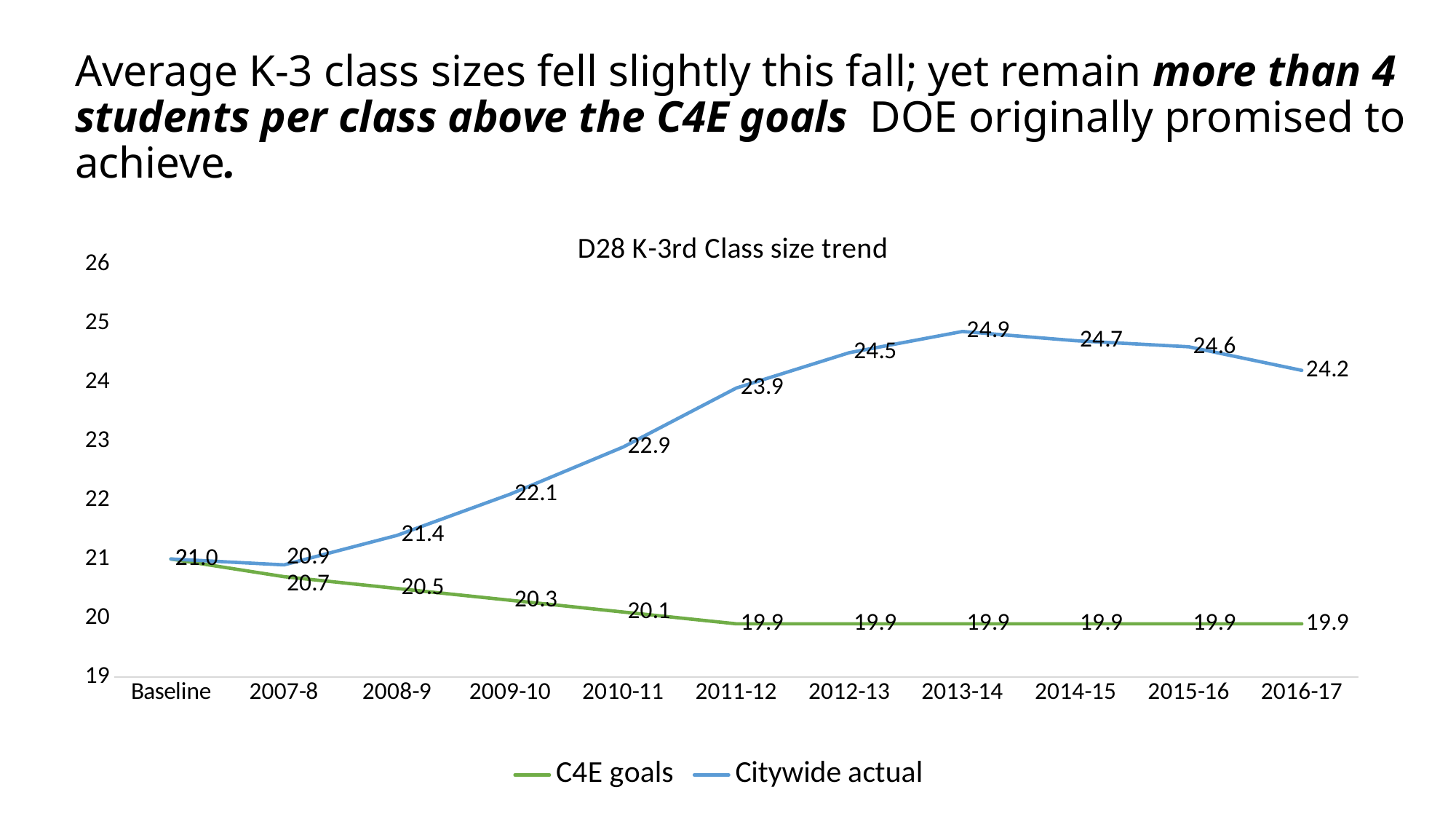
What is the Citywide actual value for 2016-17? 24.2 Does the C4E goals series rise or fall from Baseline to 2011-12? fall Is the Citywide actual value for 2012-13 greater or less than 24? greater How many series does the legend list? 2 What is the Citywide actual value for 2010-11? 22.9 What kind of chart is shown on the slide? line chart What is the difference between the Citywide actual and C4E goals values in 2016-17? 4.3 What is the C4E goals value for 2009-10? 20.3 By how much did the Citywide actual value fall from 2013-14 to 2016-17? 0.7 How many points are plotted along the x axis for each series? 11 In which year does the Citywide actual series reach its highest value? 2013-14 In 2007-8, which series has the larger value, C4E goals or Citywide actual? Citywide actual